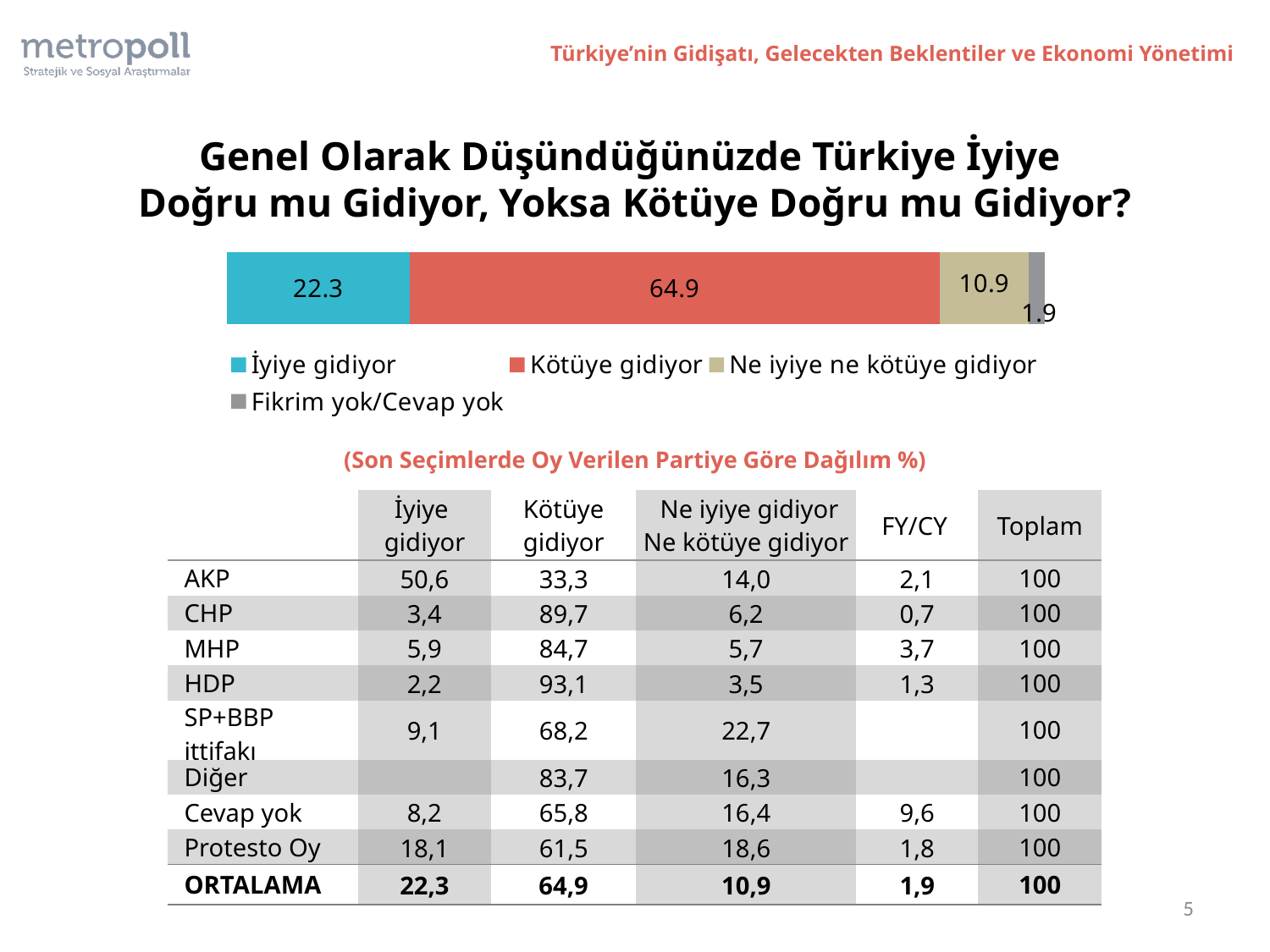
What is the difference between the "Kötüye gidiyor" and "İyiye gidiyor" values in the stacked bar chart? 42.6 What colour is the "Kötüye gidiyor" segment in the stacked bar chart? Red What value is shown for "İyiye gidiyor" in the stacked bar chart? 22.3 What value is shown for "Fikrim yok/Cevap yok" in the stacked bar chart? 1.9 What value is shown for "Ne iyiye ne kötüye gidiyor" in the stacked bar chart? 10.9 Which legend category has the largest segment in the stacked bar chart? Kötüye gidiyor How many series does the legend of the stacked bar chart list? 4 Which legend category has the smallest segment in the stacked bar chart? Fikrim yok/Cevap yok What value is shown for "Kötüye gidiyor" in the stacked bar chart? 64.9 Which is larger in the stacked bar chart: "İyiye gidiyor" or "Ne iyiye ne kötüye gidiyor"? İyiye gidiyor What is the total of all segments in the stacked bar? 100 What kind of chart is shown on the slide? Stacked bar chart